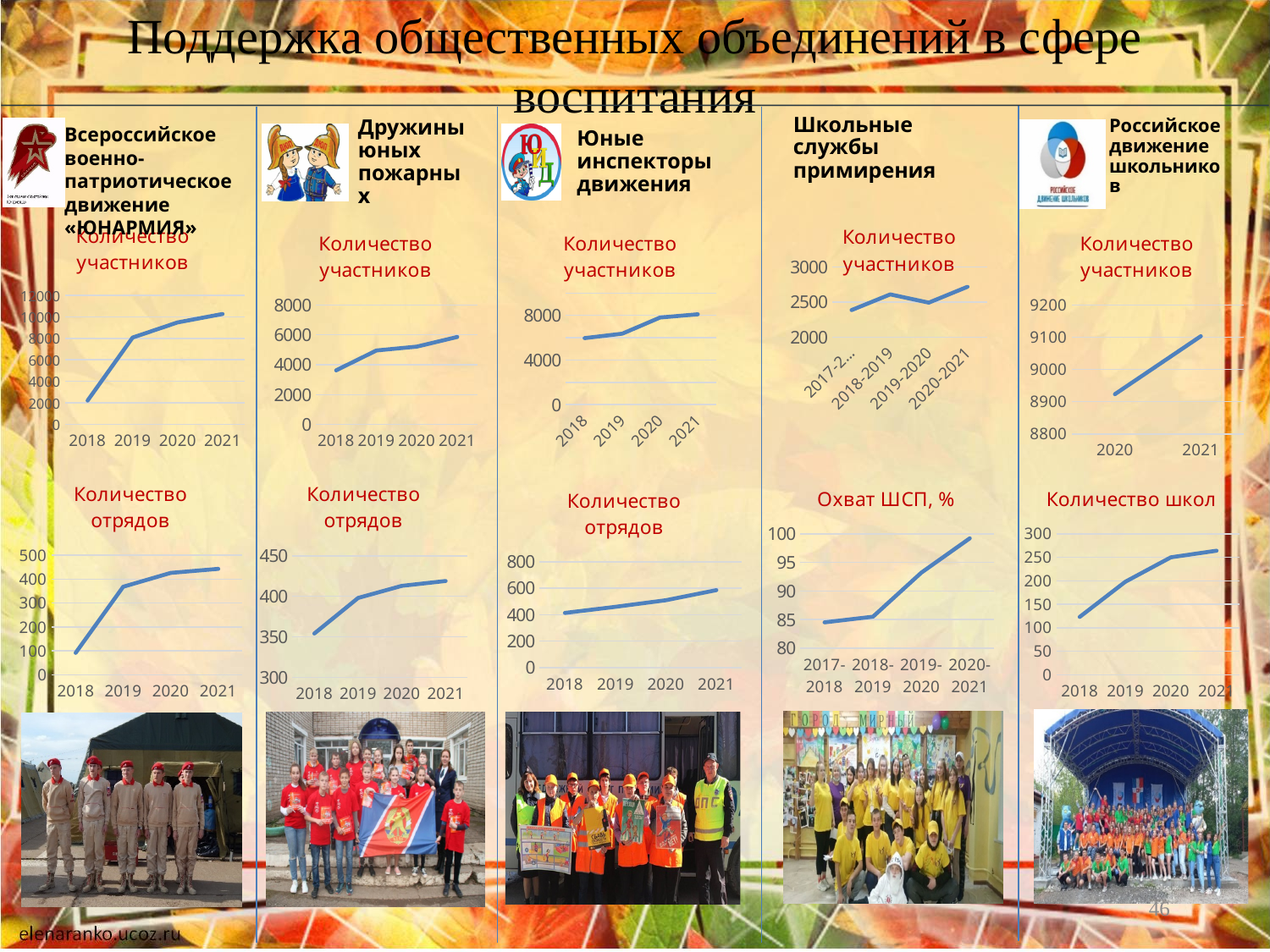
In the "Количество школ" chart, is the value for 2021 greater or less than 200? greater In the ЮНАРМИЯ "Количество участников" chart, how many years are plotted on the x axis? 4 In the "Юные инспекторы движения" "Количество отрядов" chart, do the values rise or fall from 2018 to 2021? rise In the "Российское движение школьников" "Количество участников" chart, is the value for 2021 greater or less than 9000? greater In the ЮНАРМИЯ "Количество участников" chart, is the value for 2018 greater or less than 4000? less In the ЮНАРМИЯ "Количество отрядов" chart, which year has the lowest value? 2018 In the "Российское движение школьников" "Количество участников" chart, how many years are plotted? 2 What type of chart is the "Количество участников" chart in the ЮНАРМИЯ column? line chart In the "Охват ШСП, %" chart, which period has the highest value? 2020-2021